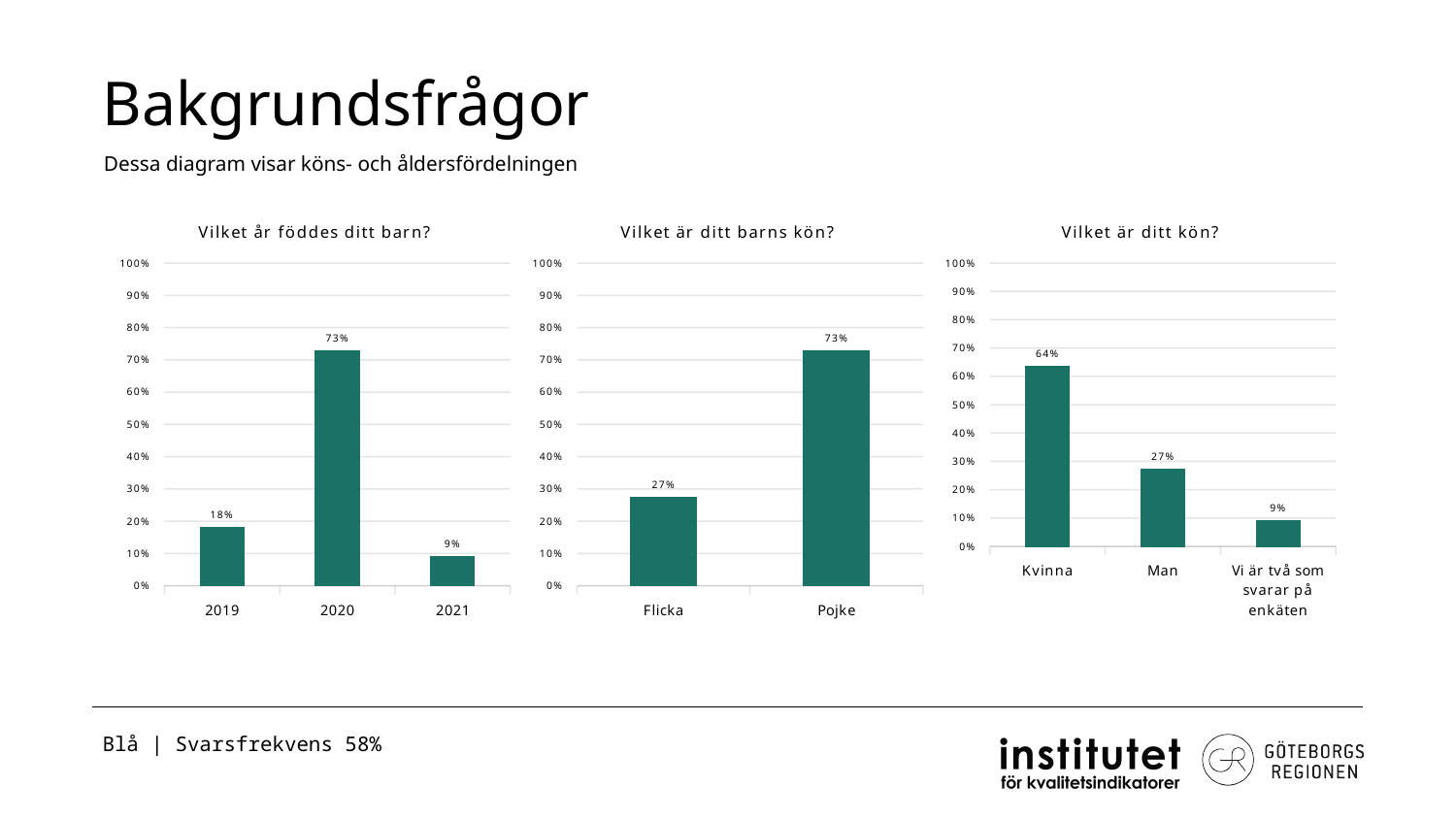
In the chart 'Vilket är ditt barns kön?', what is the difference between Pojke and Flicka? 46% What kind of chart is 'Vilket är ditt kön?'? Bar chart In the chart 'Vilket år föddes ditt barn?', how many categories are shown? 3 In the chart 'Vilket är ditt kön?', what is the value for 'Vi är två som svarar på enkäten'? 9% In the chart 'Vilket år föddes ditt barn?', what is the value for 2020? 73% In the chart 'Vilket är ditt barns kön?', which category has the highest value? Pojke In the chart 'Vilket är ditt kön?', which is larger, the value for Man or the value for Kvinna? Kvinna In the chart 'Vilket är ditt barns kön?', what is the value for Flicka? 27% In the chart 'Vilket år föddes ditt barn?', which year has the lowest value? 2021 How many charts are shown on the slide? 3 In the chart 'Vilket år föddes ditt barn?', what is the difference between the values for 2020 and 2019? 55% In the chart 'Vilket är ditt kön?', what is the value for Kvinna? 64%